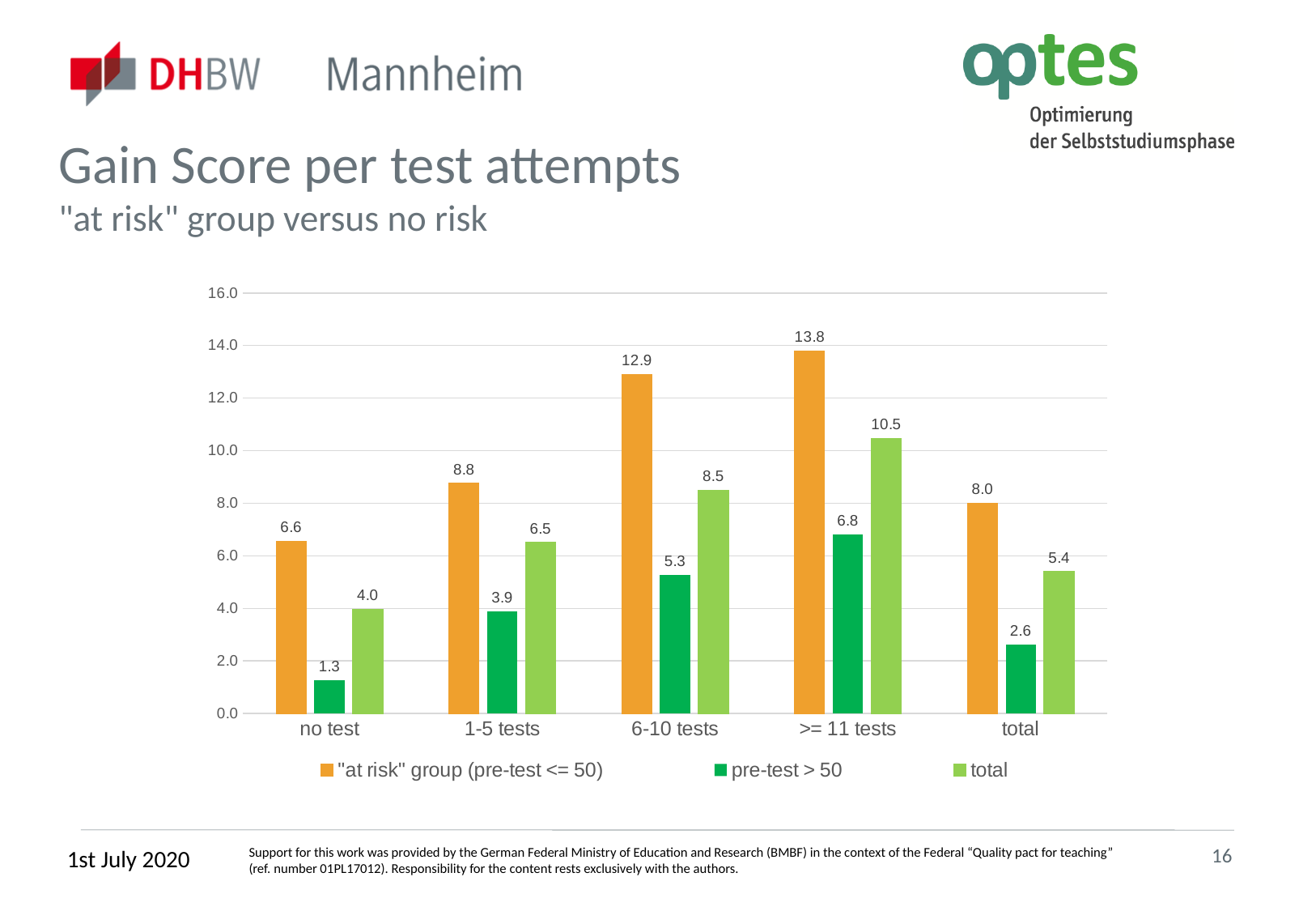
What is the total gain score for the >= 11 tests category? 10.5 What is the difference between the "at risk" group and the pre-test > 50 gain scores in the 1-5 tests category? 4.9 Is the total gain score for the 6-10 tests category greater or less than 8.0? greater Which category has the highest gain score for the "at risk" group (pre-test <= 50)? >= 11 tests What kind of chart is shown on the slide? bar chart Which is larger in the total category: the "at risk" group gain score or the total gain score? "at risk" group (pre-test <= 50) What colour represents the pre-test > 50 series? dark green What is the gain score for the "at risk" group (pre-test <= 50) in the 6-10 tests category? 12.9 What is the gain score for the pre-test > 50 series in the no test category? 1.3 How many categories are shown on the x axis? 5 How many series does the legend list? 3 Which category has the lowest gain score for the pre-test > 50 series? no test